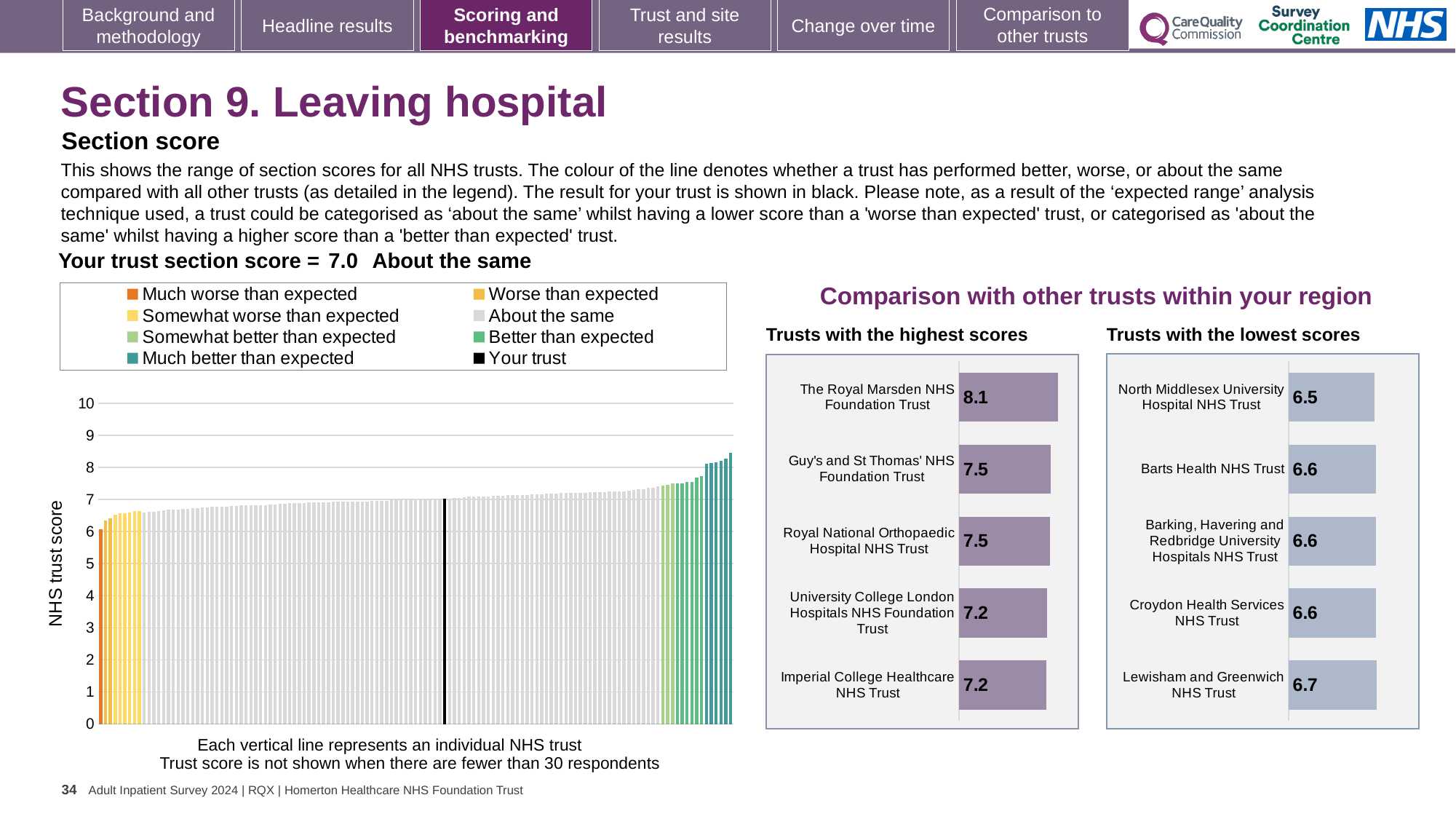
How many entries does the legend of the main NHS trust score chart list? 8 In the 'Trusts with the lowest scores' chart, what is the score for North Middlesex University Hospital NHS Trust? 6.5 In the 'Trusts with the lowest scores' chart, which has the higher score: Lewisham and Greenwich NHS Trust or Barts Health NHS Trust? Lewisham and Greenwich NHS Trust In the 'Trusts with the highest scores' chart, what is the difference between the scores of The Royal Marsden NHS Foundation Trust and Imperial College Healthcare NHS Trust? 0.9 In the 'Trusts with the lowest scores' chart, which trust has the lowest score? North Middlesex University Hospital NHS Trust What kind of chart is the main NHS trust score chart on the left? Bar chart In the main NHS trust score chart, what is the section score for your trust (shown in black)? 7.0 In the 'Trusts with the lowest scores' chart, what is the difference between the scores of Lewisham and Greenwich NHS Trust and North Middlesex University Hospital NHS Trust? 0.2 In the 'Trusts with the highest scores' chart, what is the score for The Royal Marsden NHS Foundation Trust? 8.1 In the main NHS trust score chart, do the trust scores rise or fall from left to right? Rise How many trusts are shown in the 'Trusts with the highest scores' chart? 5 In the 'Trusts with the highest scores' chart, which trust has the highest score? The Royal Marsden NHS Foundation Trust